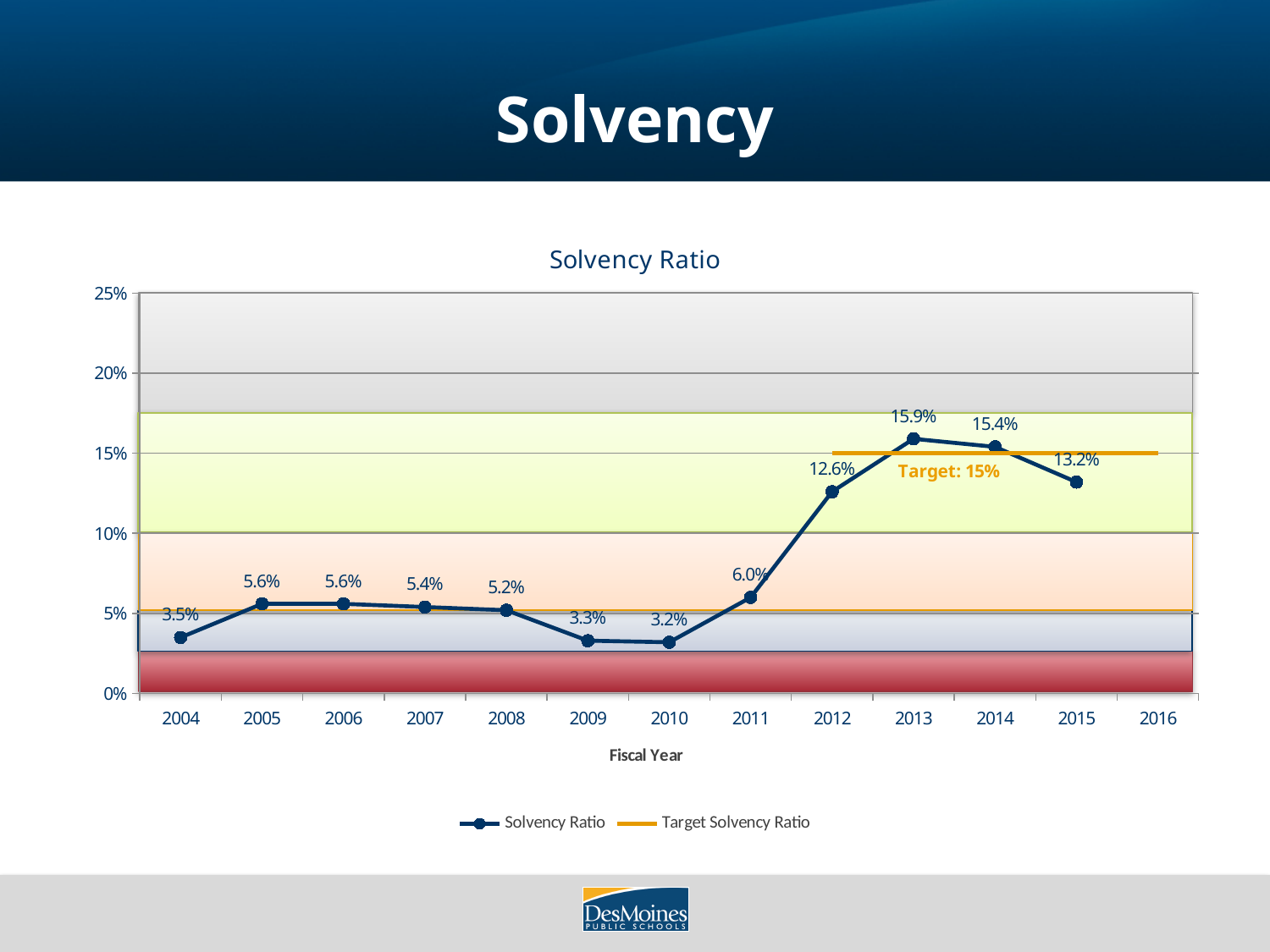
How many series does the legend list? 2 Which is larger, the solvency ratio in 2012 or in 2014? 2014 Which fiscal year has the lowest solvency ratio? 2010 What is the difference between the solvency ratio in 2013 and in 2015? 2.7% What kind of chart is shown on the slide? line chart How many fiscal years have a plotted solvency ratio data point? 12 Is the solvency ratio for 2011 greater or less than 10%? less What is the target solvency ratio shown on the chart? 15% Which fiscal year has the highest solvency ratio? 2013 What is the solvency ratio for fiscal year 2010? 3.2% What is the solvency ratio for fiscal year 2013? 15.9% What is the solvency ratio for fiscal year 2004? 3.5%